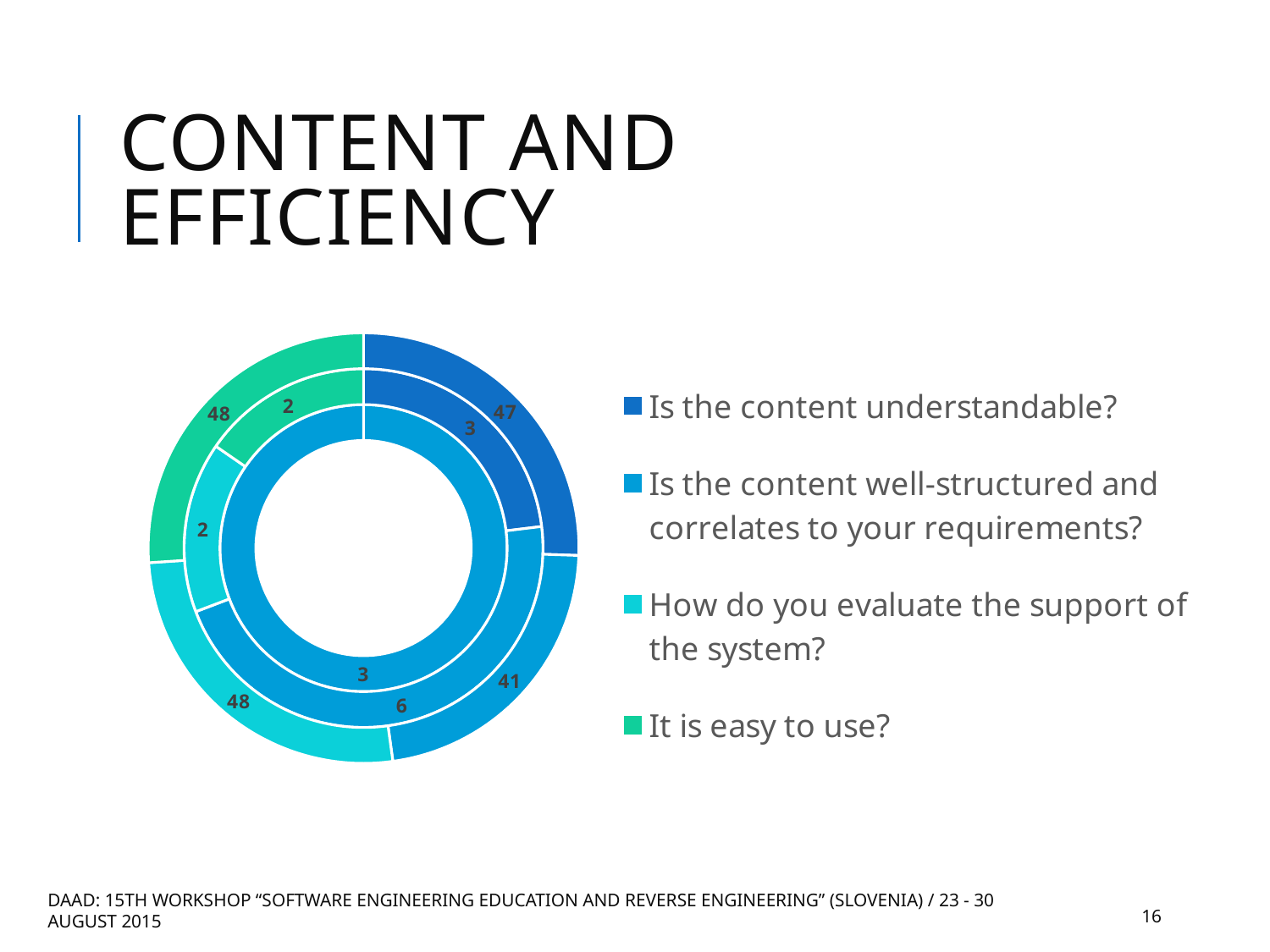
How many entries does the chart legend list? 4 In the outer ring of the doughnut chart, what value is shown for "How do you evaluate the support of the system?"? 48 In the outer ring, which is larger: the value for "Is the content understandable?" or for "Is the content well-structured and correlates to your requirements?"? Is the content understandable? What colour represents "It is easy to use?" in the chart legend? Green What kind of chart is shown on the slide? Doughnut chart In the outer ring of the doughnut chart, what value is shown for "Is the content well-structured and correlates to your requirements?"? 41 In the outer ring, what is the difference between the value for "Is the content understandable?" and the value for "Is the content well-structured and correlates to your requirements?"? 6 In the outer ring of the doughnut chart, which legend category has the lowest value? Is the content well-structured and correlates to your requirements? In the middle ring of the doughnut chart, what value is shown for "Is the content understandable?"? 3 In the outer ring of the doughnut chart, what value is shown for "It is easy to use?"? 48 In the outer ring of the doughnut chart, what value is shown for "Is the content understandable?"? 47 In the middle ring of the doughnut chart, what value is shown for "Is the content well-structured and correlates to your requirements?"? 6